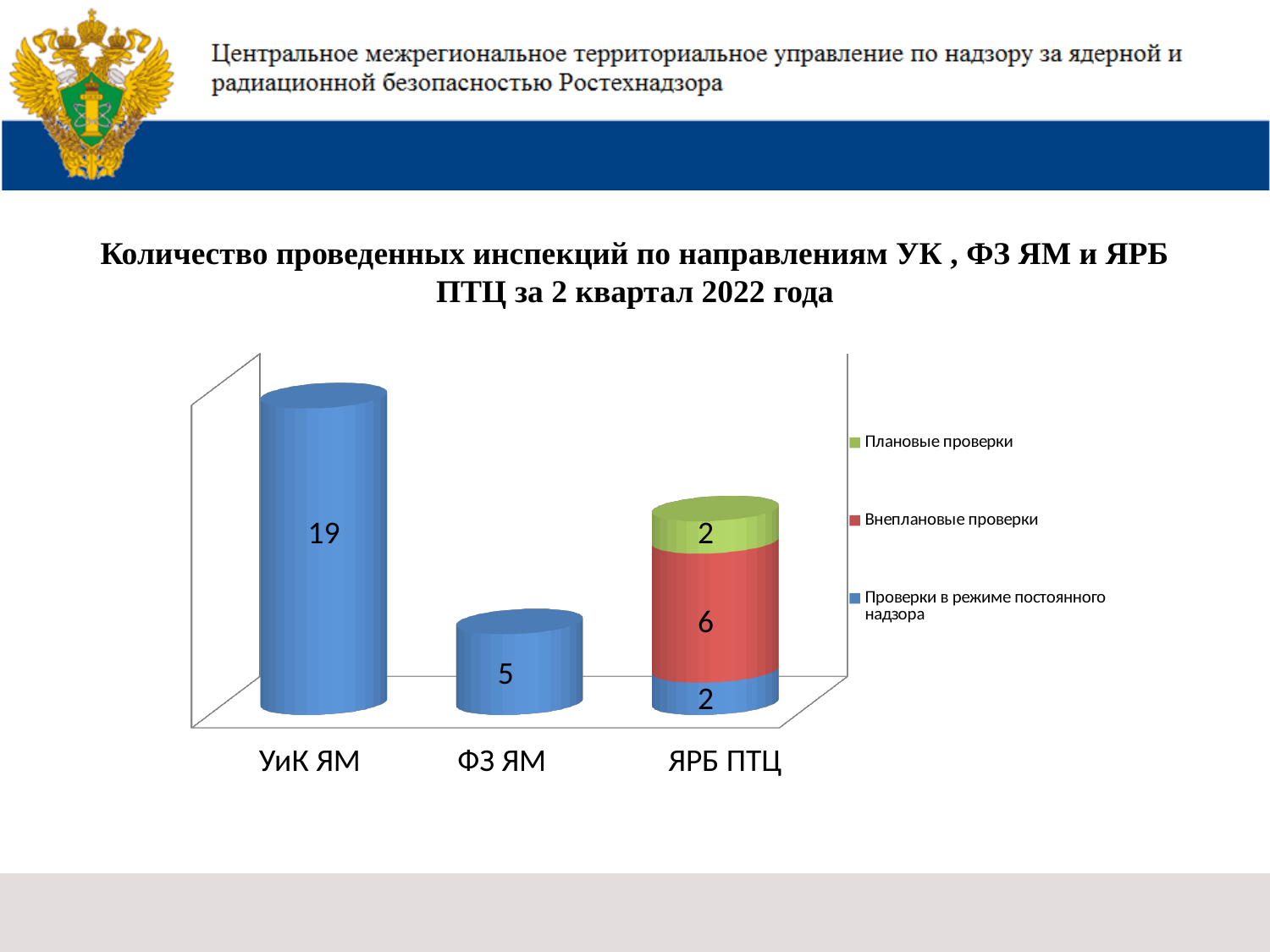
What is the value for ЯРБ ПТЦ in the series 'Проверки в режиме постоянного надзора'? 2 What is the total of the stacked bar for ЯРБ ПТЦ? 10 How many series does the legend list? 3 What is the value for ЯРБ ПТЦ in the series 'Плановые проверки'? 2 What kind of chart is shown on the slide? Stacked bar chart What is the value for УиК ЯМ in the series 'Проверки в режиме постоянного надзора'? 19 What is the value for ФЗ ЯМ in the series 'Проверки в режиме постоянного надзора'? 5 How many categories are shown on the x axis? 3 What is the difference between the 'Проверки в режиме постоянного надзора' values for УиК ЯМ and ФЗ ЯМ? 14 Which category has the highest value for 'Проверки в режиме постоянного надзора'? УиК ЯМ What is the value for ЯРБ ПТЦ in the series 'Внеплановые проверки'? 6 Which category has the lowest value for 'Проверки в режиме постоянного надзора'? ЯРБ ПТЦ